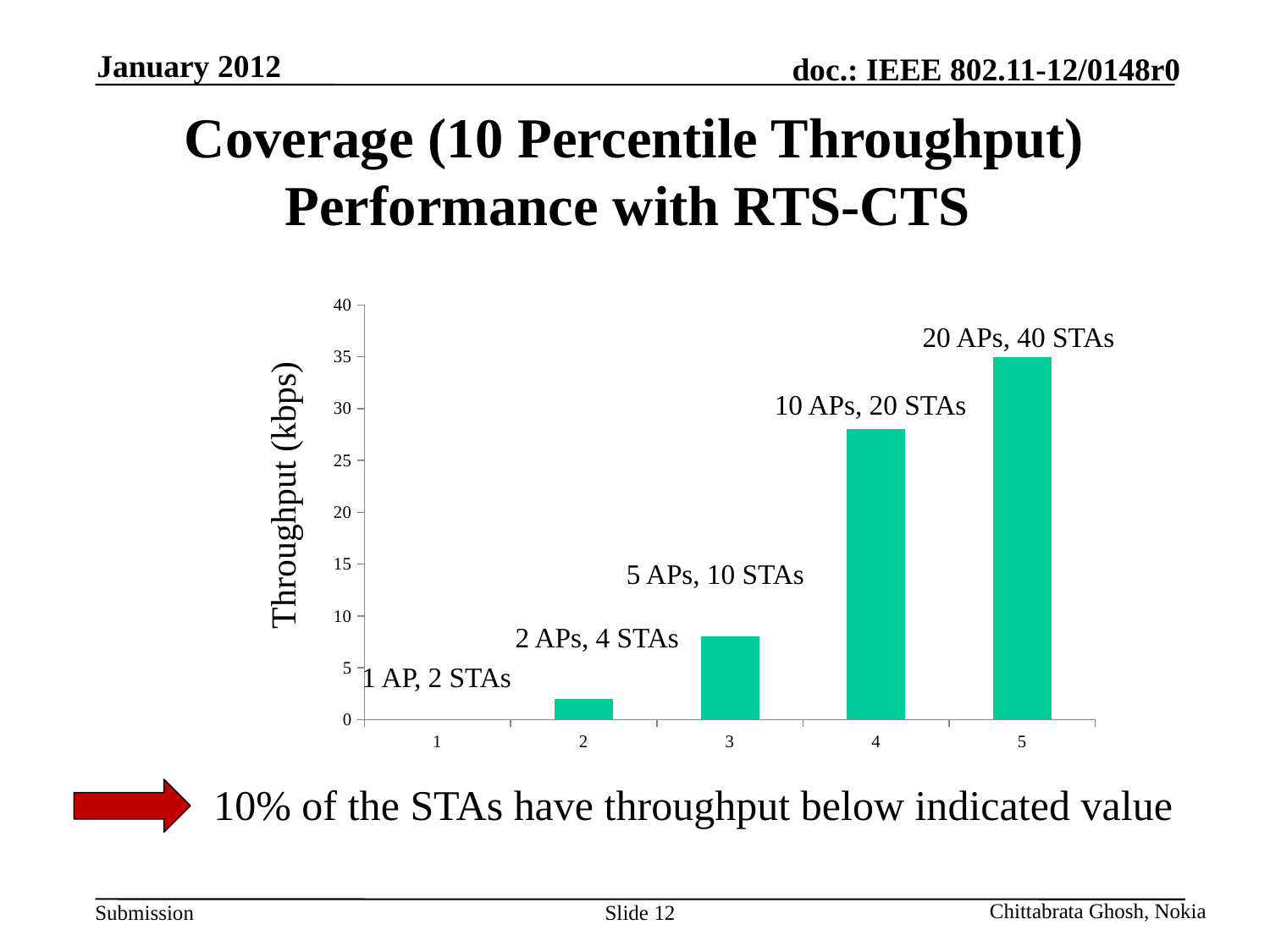
Is the throughput for 20 APs, 40 STAs greater or less than 30 kbps? greater Is the throughput for 10 APs, 20 STAs greater or less than 30 kbps? less What kind of chart is shown on the slide? bar chart Is the throughput for 2 APs, 4 STAs greater or less than 5 kbps? less How many bars are plotted in the chart? 5 Which has the larger throughput: 5 APs, 10 STAs or 10 APs, 20 STAs? 10 APs, 20 STAs Do the throughput values rise or fall as the number of APs and STAs increases along the x axis? rise Which configuration has the highest throughput in the chart? 20 APs, 40 STAs What is the label of the vertical axis of the chart? Throughput (kbps) Which configuration has the lowest throughput in the chart? 1 AP, 2 STAs